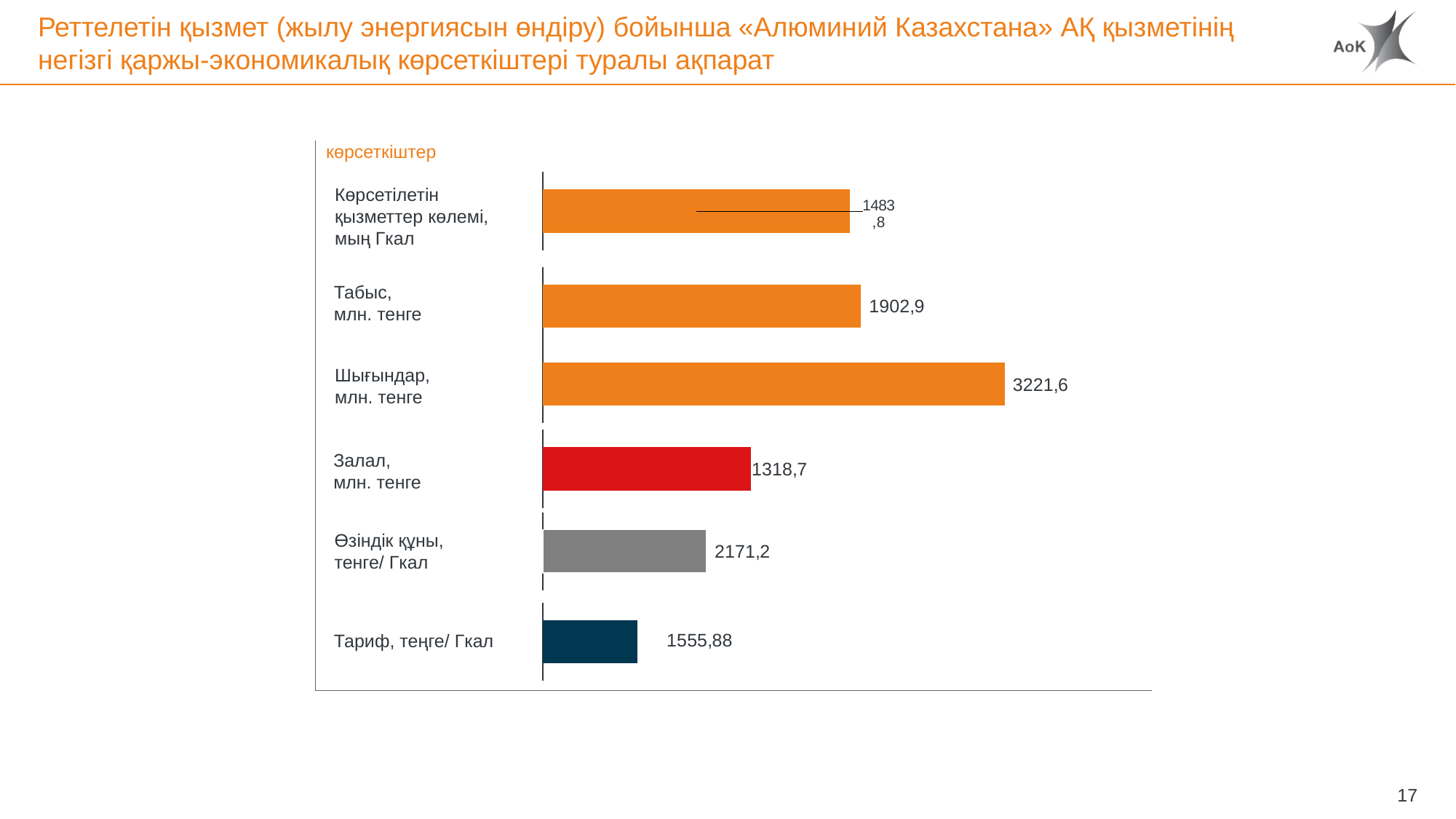
What is the value for Көрсетілетін қызметтер көлемі, мың Гкал? 1483,8 What is the value for Өзіндік құны, тенге/ Гкал? 2171,2 What is the value for Залал, млн. тенге? 1318,7 How many categories are shown in the chart? 6 Which category has the lowest labelled value? Залал, млн. тенге What is the value for Шығындар, млн. тенге? 3221,6 What is the value for Тариф, теңге/ Гкал? 1555,88 Which is larger: Өзіндік құны, тенге/ Гкал or Тариф, теңге/ Гкал? Өзіндік құны, тенге/ Гкал What is the difference between Шығындар, млн. тенге and Табыс, млн. тенге? 1318,7 Which category has the highest labelled value? Шығындар, млн. тенге What is the value for Табыс, млн. тенге? 1902,9 What type of chart is shown on the slide? Bar chart